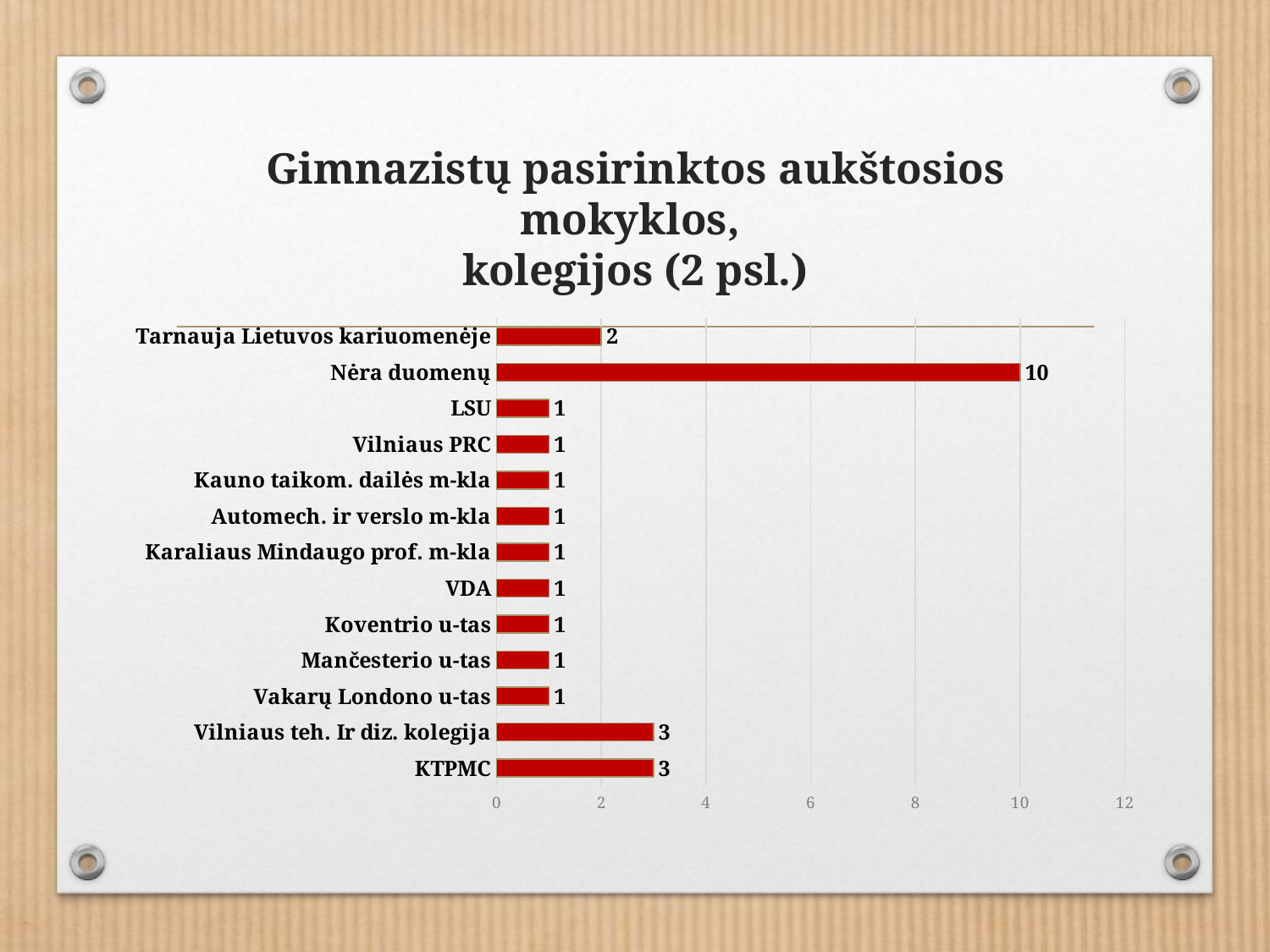
What is the value for Vilniaus PRC? 1 What is the title of the chart? Gimnazistų pasirinktos aukštosios mokyklos, kolegijos (2 psl.) Which category has the highest value? Nėra duomenų How many categories have a value of 1? 9 What is the value for Nėra duomenų? 10 Is the value for Nėra duomenų greater or less than 8? greater What kind of chart is shown on the slide? bar chart How many categories are shown in the chart? 13 What is the value for KTPMC? 3 What is the value for Tarnauja Lietuvos kariuomenėje? 2 Which is larger, the value for KTPMC or the value for Tarnauja Lietuvos kariuomenėje? KTPMC What is the difference between the values for Nėra duomenų and Vilniaus teh. Ir diz. kolegija? 7